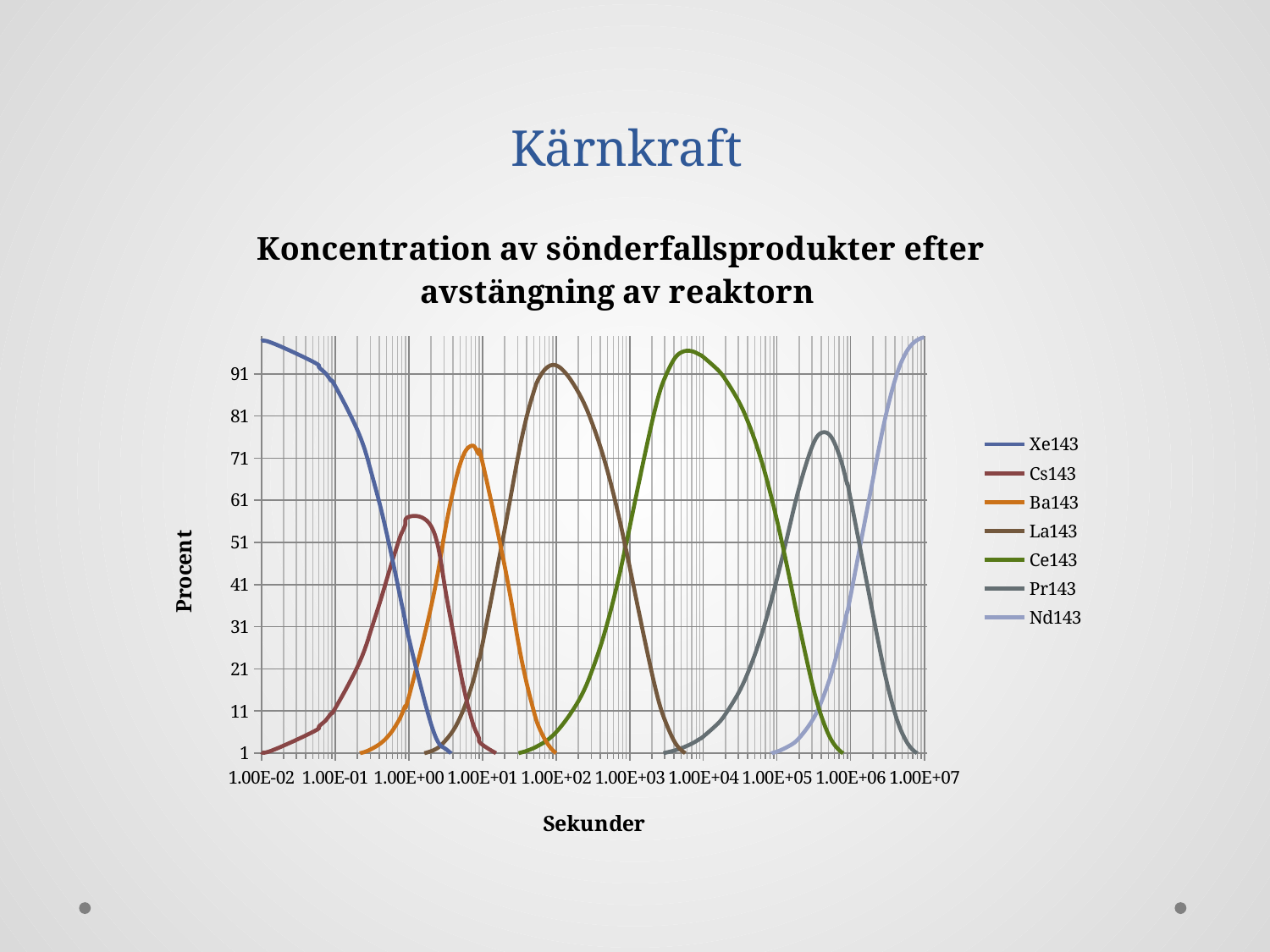
Is the peak value of La143 greater or less than 81? greater What is the label of the vertical axis? Procent Which series has the lowest peak value? Cs143 How many series does the legend list? 7 Is the peak value of Pr143 greater or less than 71? greater Which series has a higher peak, Cs143 or Ba143? Ba143 Which series has a higher peak, Ce143 or Pr143? Ce143 What kind of chart is shown on the slide? line chart What is the title of the chart? Koncentration av sönderfallsprodukter efter avstängning av reaktorn Does the Xe143 series rise or fall along the x axis? fall Does the Nd143 series rise or fall along the x axis? rise Is the peak value of Cs143 greater or less than 61? less